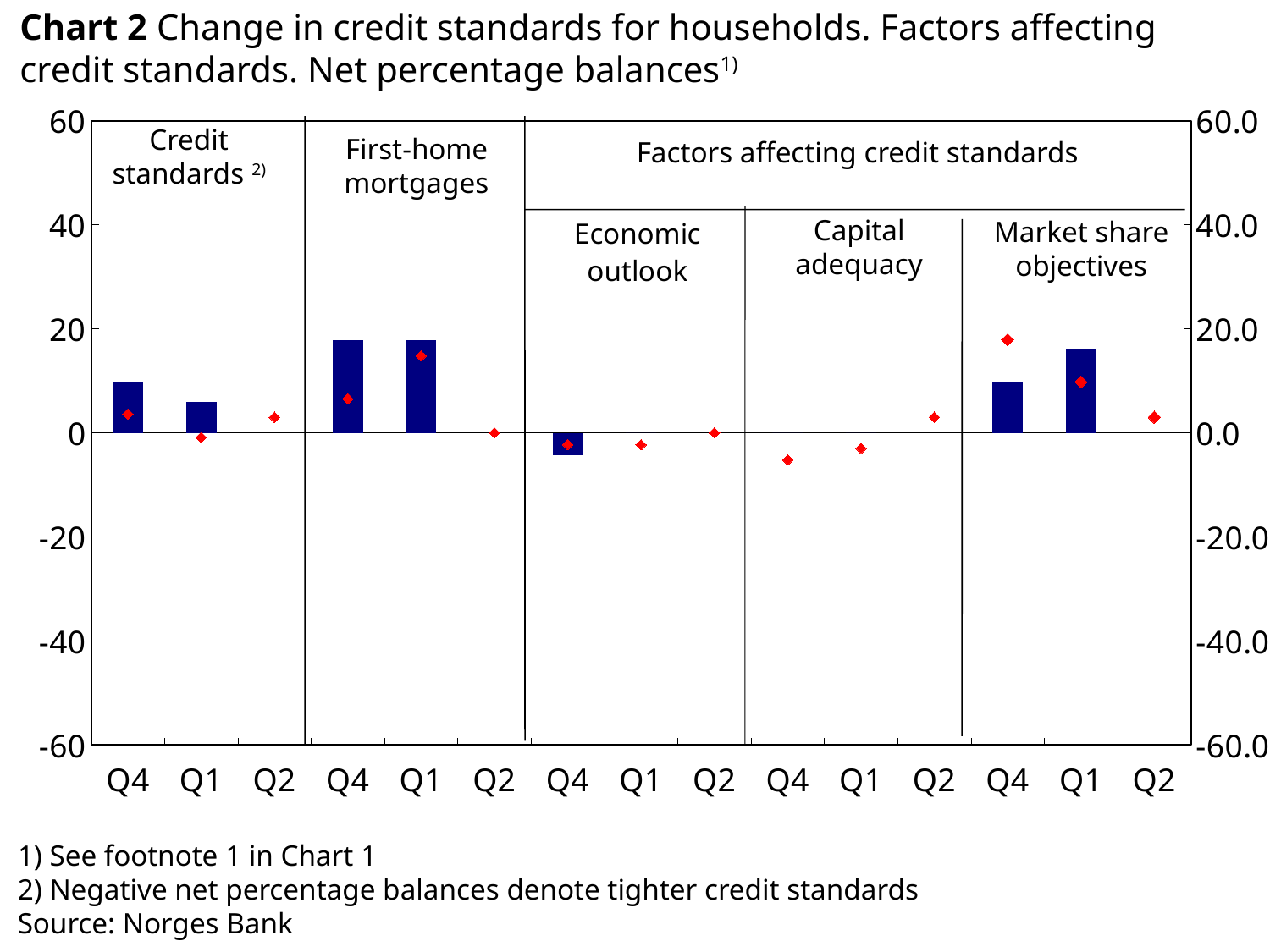
In the Capital adequacy panel, is the Q4 red diamond marker greater or less than 0? less What kind of chart is shown on the slide? bar chart with diamond markers (combination bar and line chart) How many quarter labels are shown along the x axis in total? 15 In the Economic outlook panel, is the Q4 bar greater or less than 0? less In the Market share objectives panel, which bar is taller, Q4 or Q1? Q1 How many labelled panels (sections) does the chart have along the x axis? 5 In the Market share objectives panel, is the Q4 red diamond marker greater or less than 10? greater Which panel of the chart contains no bars at all, only diamond markers? Capital adequacy In the Credit standards panel, do the bars rise or fall from Q4 to Q1? fall In the Credit standards panel, which bar is taller, Q4 or Q1? Q4 What is the range of the vertical axis shown on the chart? -60 to 60